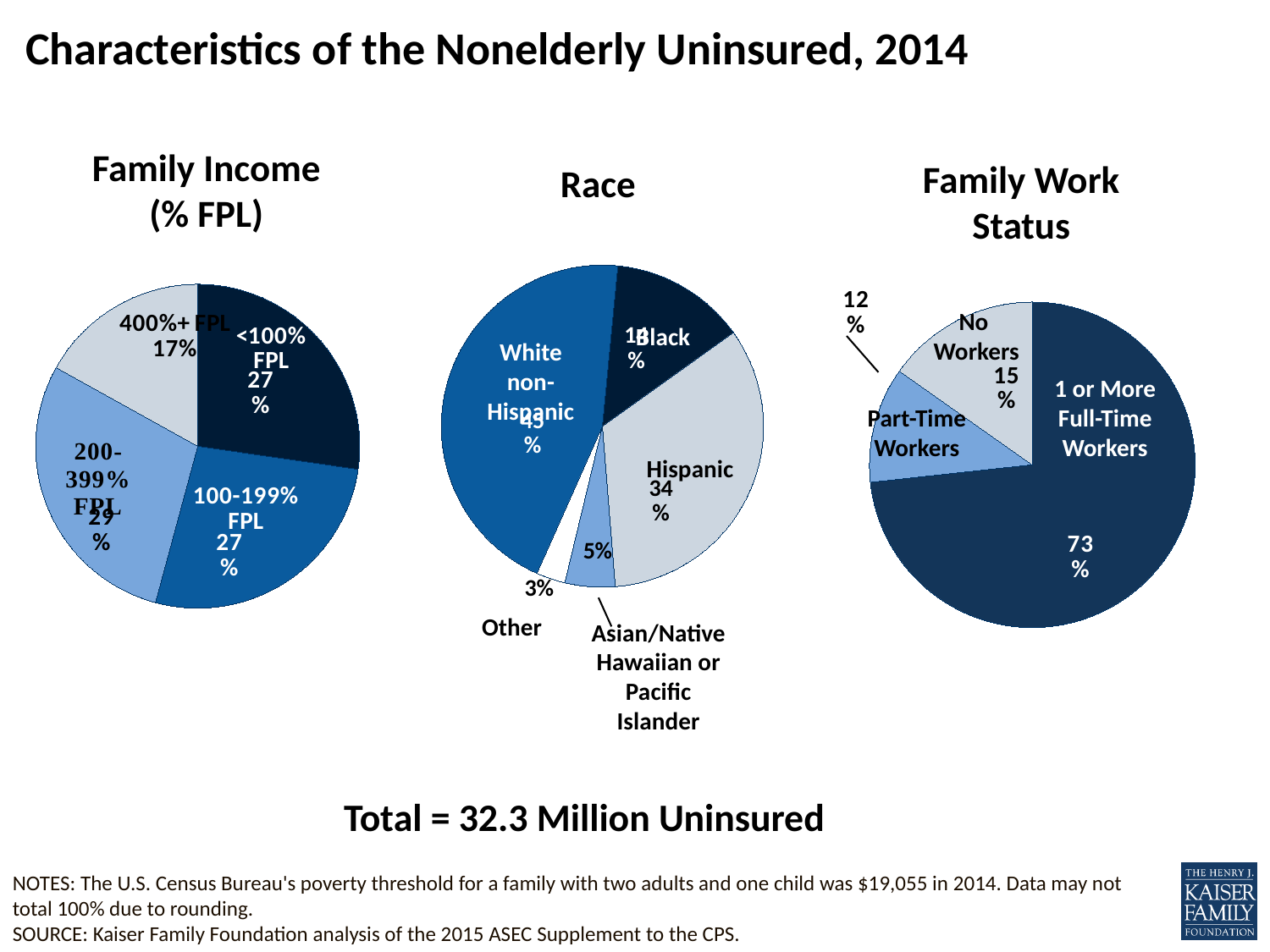
In the Family Work Status chart, what share are in families with no workers? 15% How many income categories are shown in the Family Income (% FPL) pie chart? 4 In the Family Income (% FPL) chart, what share of the nonelderly uninsured have family income of 400%+ FPL? 17% In the Family Work Status chart, how many percentage points larger is the share for 1 or More Full-Time Workers than for No Workers? 58 percentage points In the Race chart, what share are Asian/Native Hawaiian or Pacific Islander? 5% In the Family Work Status chart, what share of the nonelderly uninsured are in families with 1 or more full-time workers? 73% What type of chart is used for the Race breakdown on this slide? Pie chart In the Family Income (% FPL) chart, what share have family income below 100% FPL? 27% In the Race chart, which racial group makes up the largest share of the nonelderly uninsured? White non-Hispanic In the Family Income (% FPL) chart, which income group has the smallest share? 400%+ FPL In the Race chart, what share of the nonelderly uninsured are Hispanic? 34% In the Race chart, what share are in the Other category? 3%